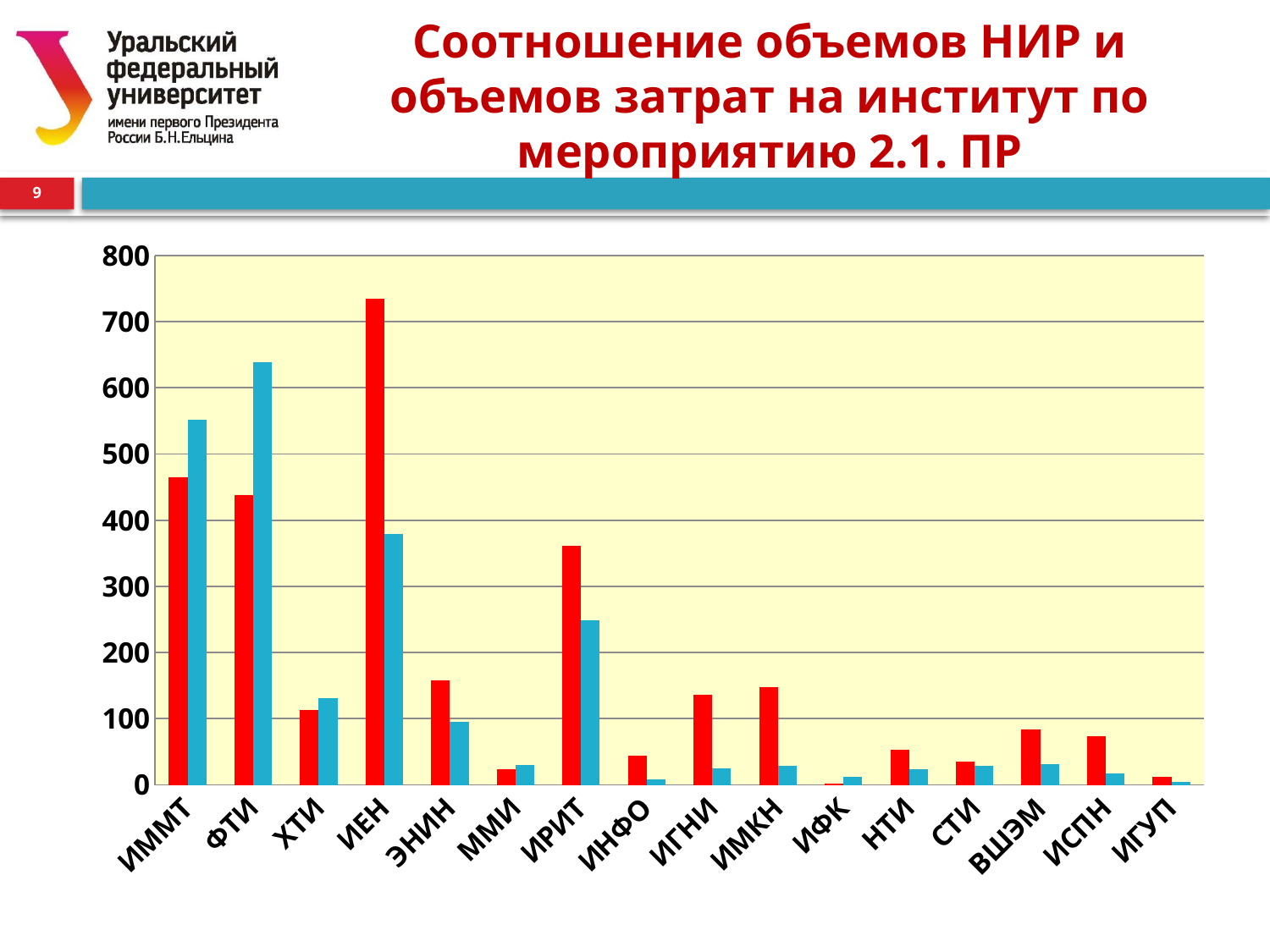
Is the blue bar for ИРИТ greater or less than 300? less Is the blue bar for ФТИ greater or less than 600? greater Is the red bar for ИЕН greater or less than 700? greater For ИЕН, which bar is taller, the red one or the blue one? red Which institute has the tallest red bar in the chart? ИЕН For ИММТ, which bar is taller, the red one or the blue one? blue Which institute has the shortest red bar in the chart? ИФК What kind of chart is shown on the slide? bar chart How many institutes (categories) are shown on the x axis of the chart? 16 How many series (bar colours) are plotted for each institute in the chart? 2 Which institute has the tallest blue bar in the chart? ФТИ